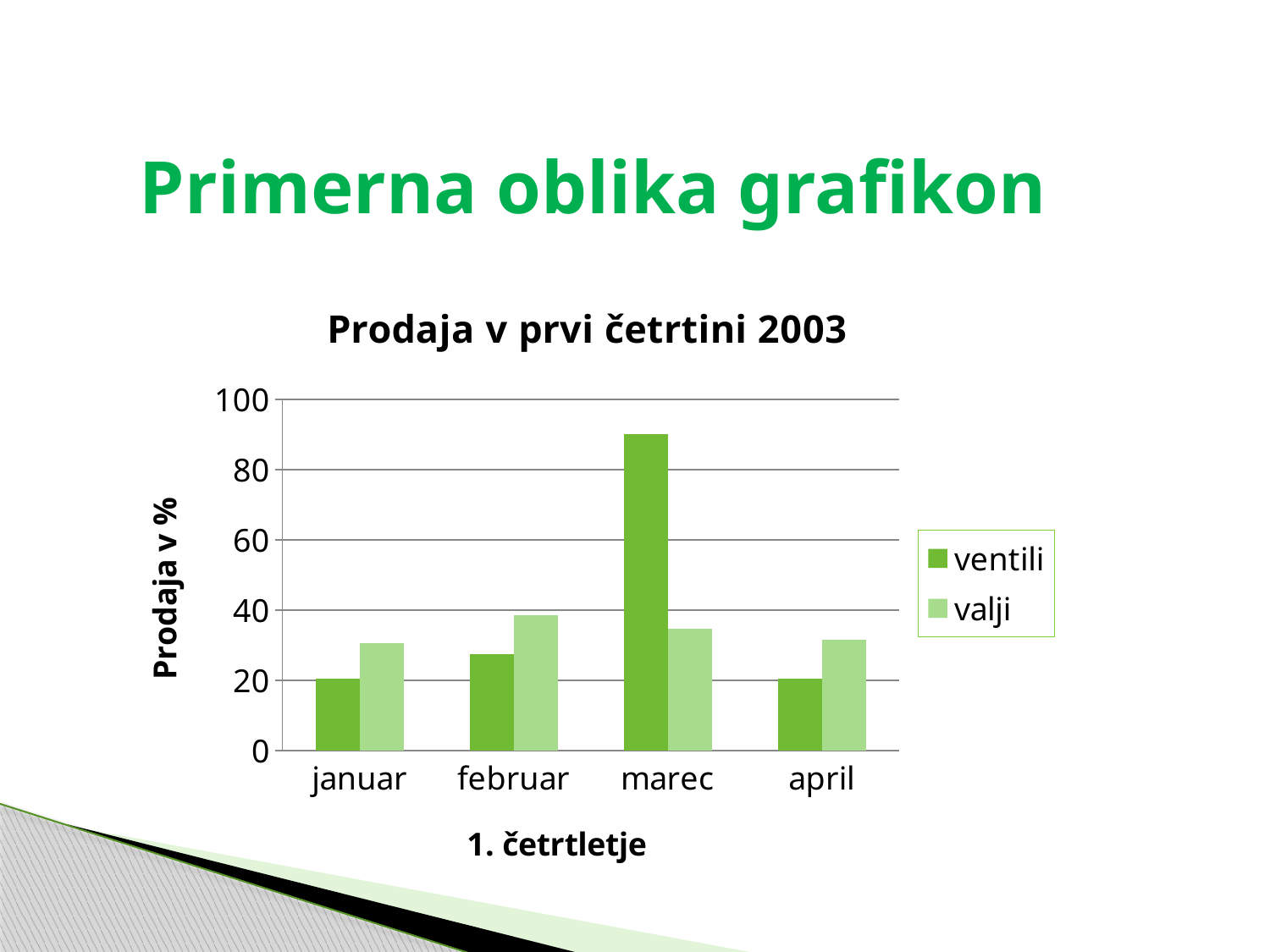
What is the label of the y axis? Prodaja v % In januar, which series has the larger value, ventili or valji? valji Is the value for valji in marec greater or less than 60? less In marec, which series has the larger value, ventili or valji? ventili Is the value for ventili in februar greater or less than 40? less In which month is the value for ventili highest? marec How many categories are shown on the x axis? 4 What kind of chart is shown on the slide? bar chart Is the value for ventili in marec greater or less than 80? greater What is the title of the chart? Prodaja v prvi četrtini 2003 How many series does the legend list? 2